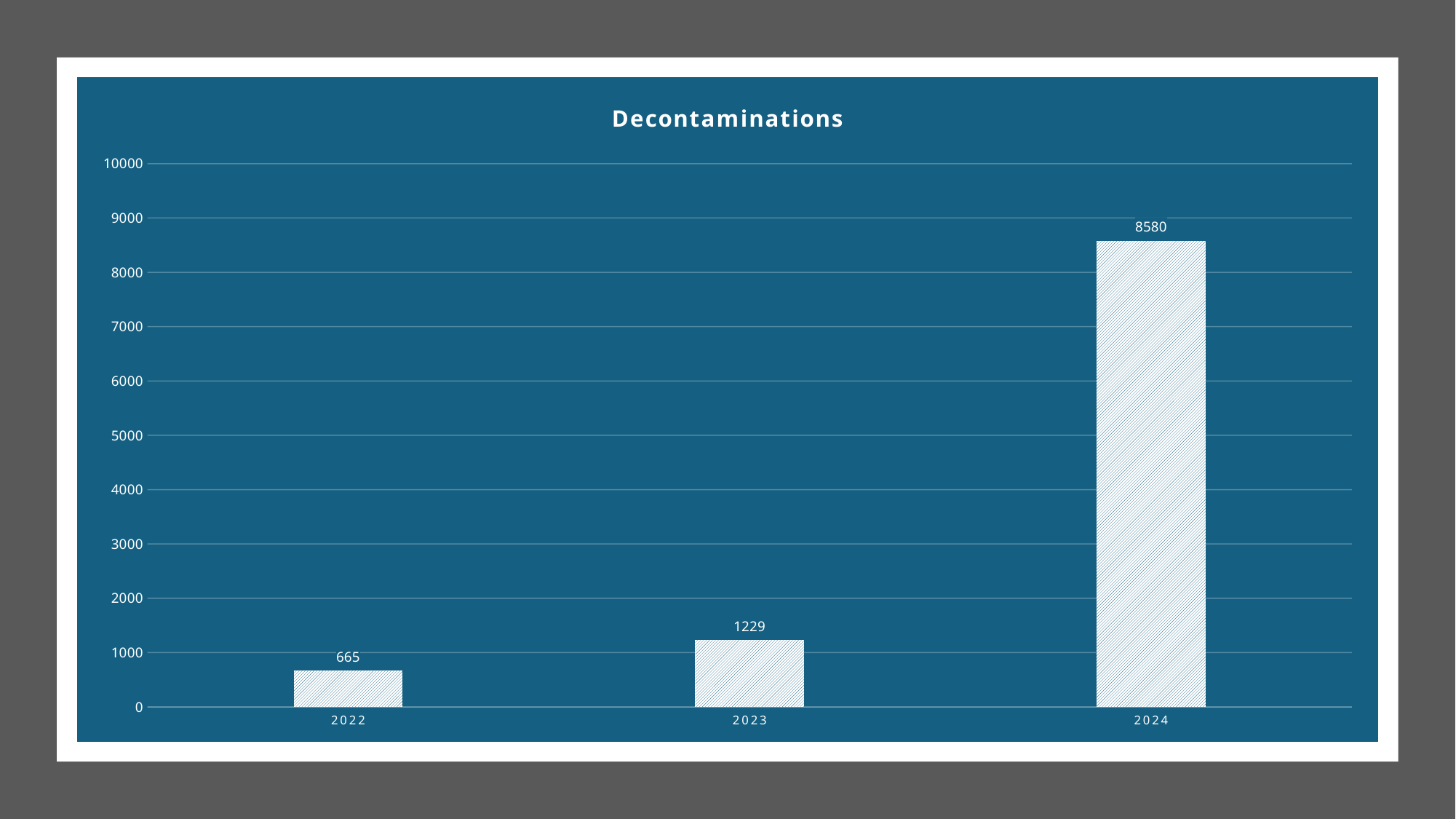
Which is larger, the value for 2022 or the value for 2023? 2023 What kind of chart is shown? bar chart Is the value for 2024 greater or less than 8000? greater Do the values rise or fall from 2022 to 2024? rise What is the value for 2023? 1229 What is the difference between the values for 2023 and 2022? 564 What is the difference between the values for 2024 and 2023? 7351 Which year has the highest value? 2024 How many years are shown on the x axis? 3 What is the value for 2024? 8580 What is the value for 2022? 665 Which year has the lowest value? 2022